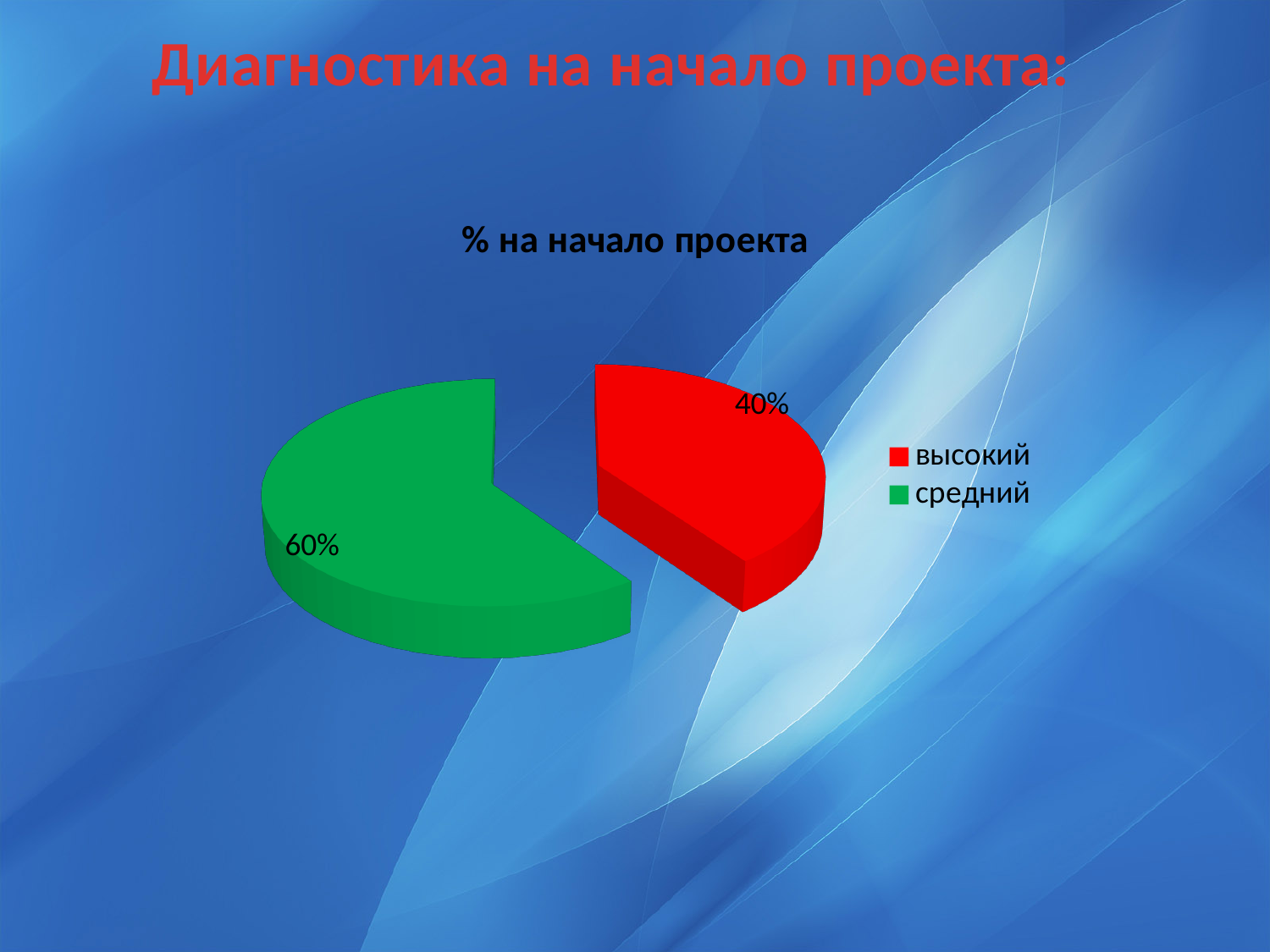
What percentage is shown for the "средний" slice? 60% What is the difference between the "средний" and "высокий" slices? 20% How many slices does the pie chart have? 2 What is the title of the chart? % на начало проекта What kind of chart is shown on the slide? pie chart Which is larger, the "высокий" slice or the "средний" slice? средний What colour is the "высокий" slice? red What percentage is shown for the "высокий" slice? 40% What share of the pie does the "средний" slice represent? 60% Which category has the smallest slice of the pie? высокий How many entries does the legend list? 2 Which category has the largest slice of the pie? средний